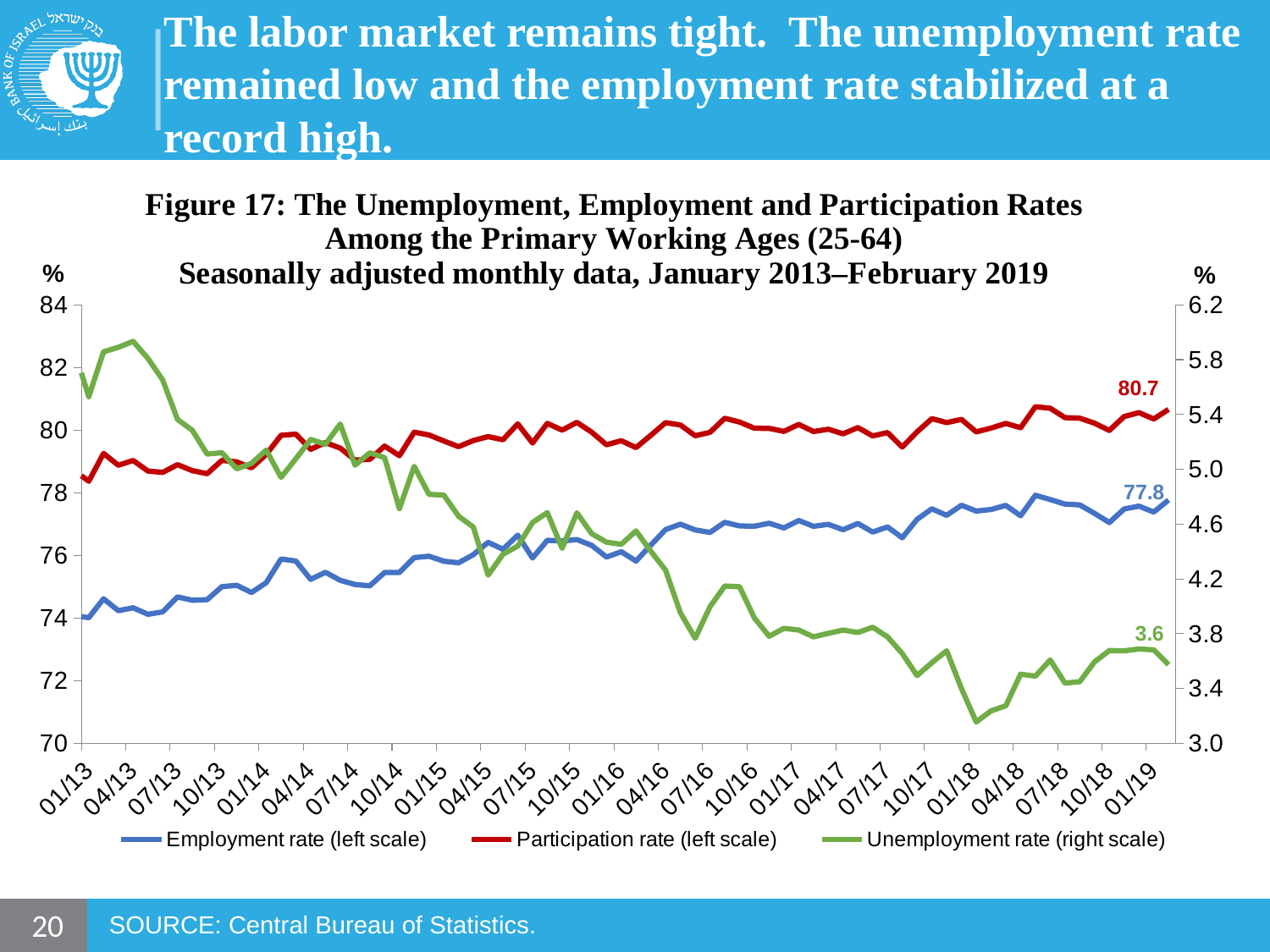
What is the difference between the labeled final participation rate (80.7) and the labeled final employment rate (77.8)? 2.9 Does the employment rate generally rise or fall from January 2013 to February 2019? rise What is the labeled final value of the employment rate? 77.8 Does the unemployment rate generally rise or fall from January 2013 to February 2019? fall What kind of chart is shown on the slide? line chart How many series does the legend list? 3 Is the employment rate at 01/13 greater or less than 76? less At the end of the period, which is larger: the participation rate or the employment rate? Participation rate What is the labeled final value of the unemployment rate? 3.6 Which series is plotted on the right scale? Unemployment rate What is the labeled final value of the participation rate? 80.7 Is the unemployment rate at 01/13 greater or less than 5.0? greater